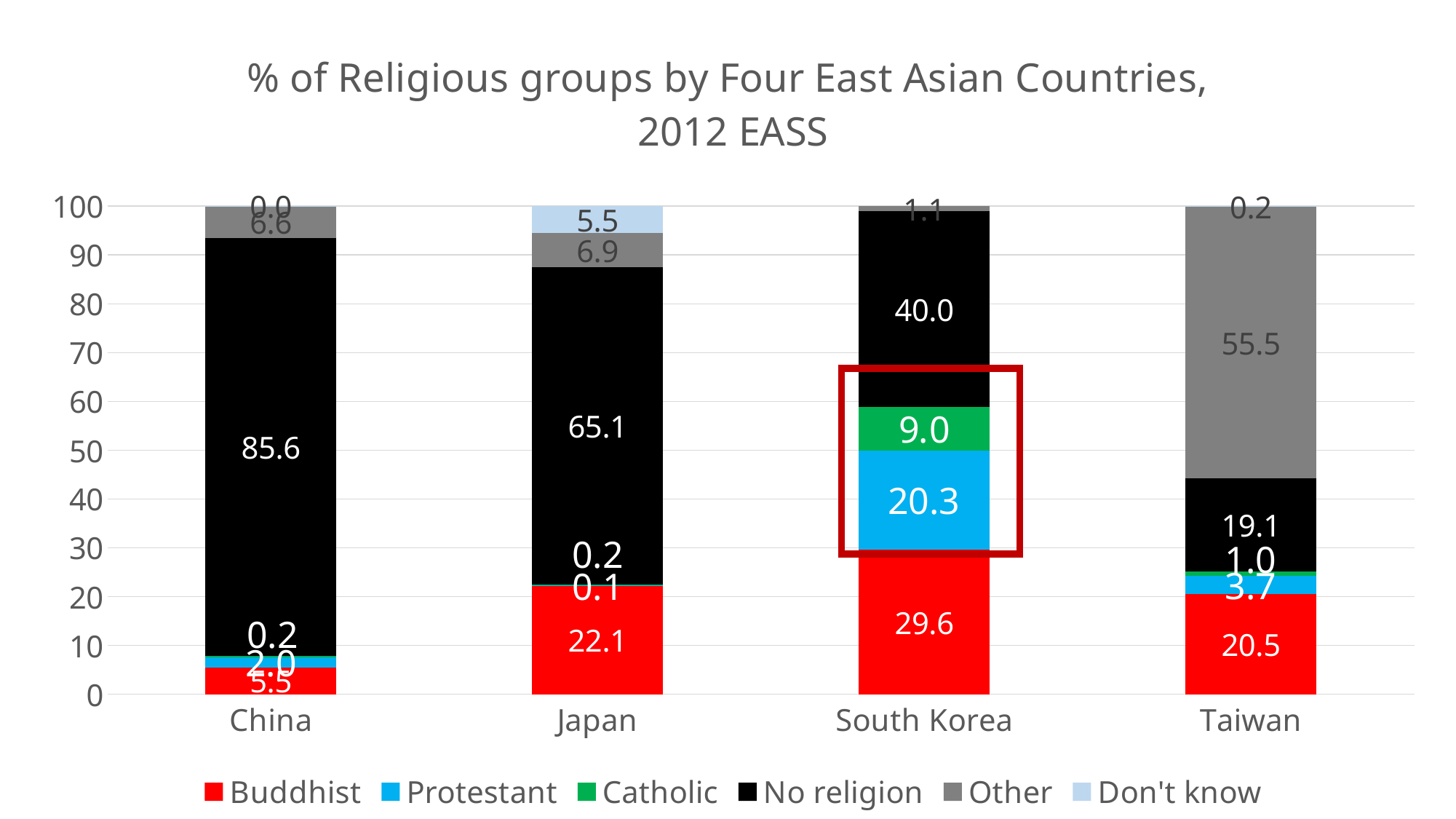
What is the difference between the Buddhist percentages of South Korea and Japan? 7.5 What kind of chart is shown on the slide? Stacked bar chart Which is larger: the Catholic percentage in South Korea or in Taiwan? South Korea Which country has the lowest Buddhist percentage? China What is the 'Other' percentage for Taiwan? 55.5 Which country has the highest 'No religion' percentage? China What is the Buddhist percentage for South Korea? 29.6 What percentage of people in China report no religion? 85.6 What is the 'Don't know' percentage for Japan? 5.5 How many countries are shown on the x axis? 4 How many series does the legend list? 6 What is the Protestant percentage for South Korea? 20.3